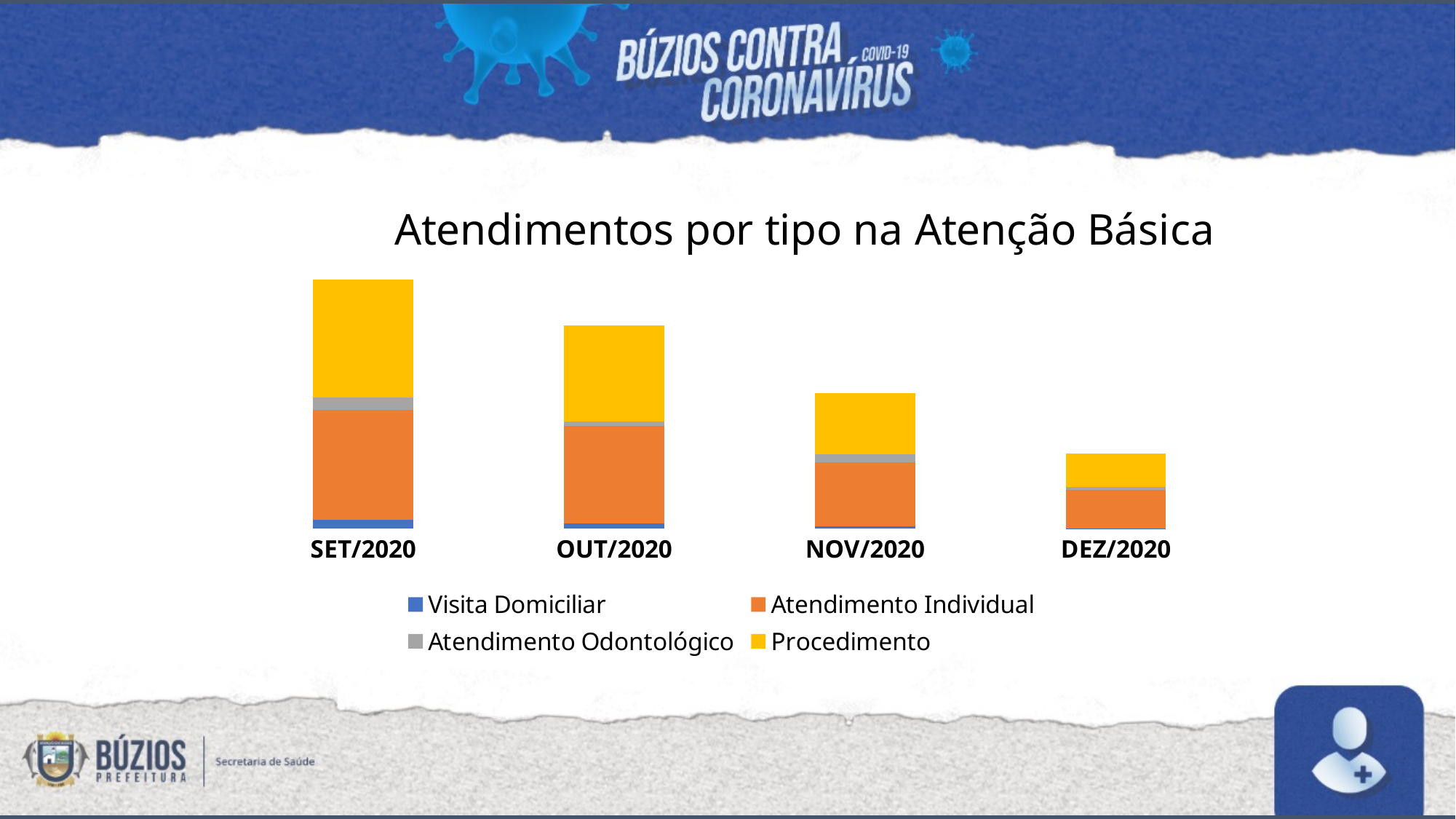
Is the total bar for OUT/2020 taller or shorter than the total bar for NOV/2020? Taller Do the total bar heights rise or fall from SET/2020 to DEZ/2020? Fall How many series does the chart's legend list? 4 Which month has the tallest stacked bar in the chart? SET/2020 What is the title of the chart? Atendimentos por tipo na Atenção Básica Which series forms the largest segment of the SET/2020 bar, Procedimento or Visita Domiciliar? Procedimento What kind of chart is shown on the slide? Stacked bar chart Which series is shown in yellow in the chart? Procedimento How many months (categories) are shown on the x axis of the chart? 4 Is the Atendimento Individual segment for SET/2020 larger or smaller than the Atendimento Individual segment for DEZ/2020? Larger Which month has the shortest stacked bar in the chart? DEZ/2020